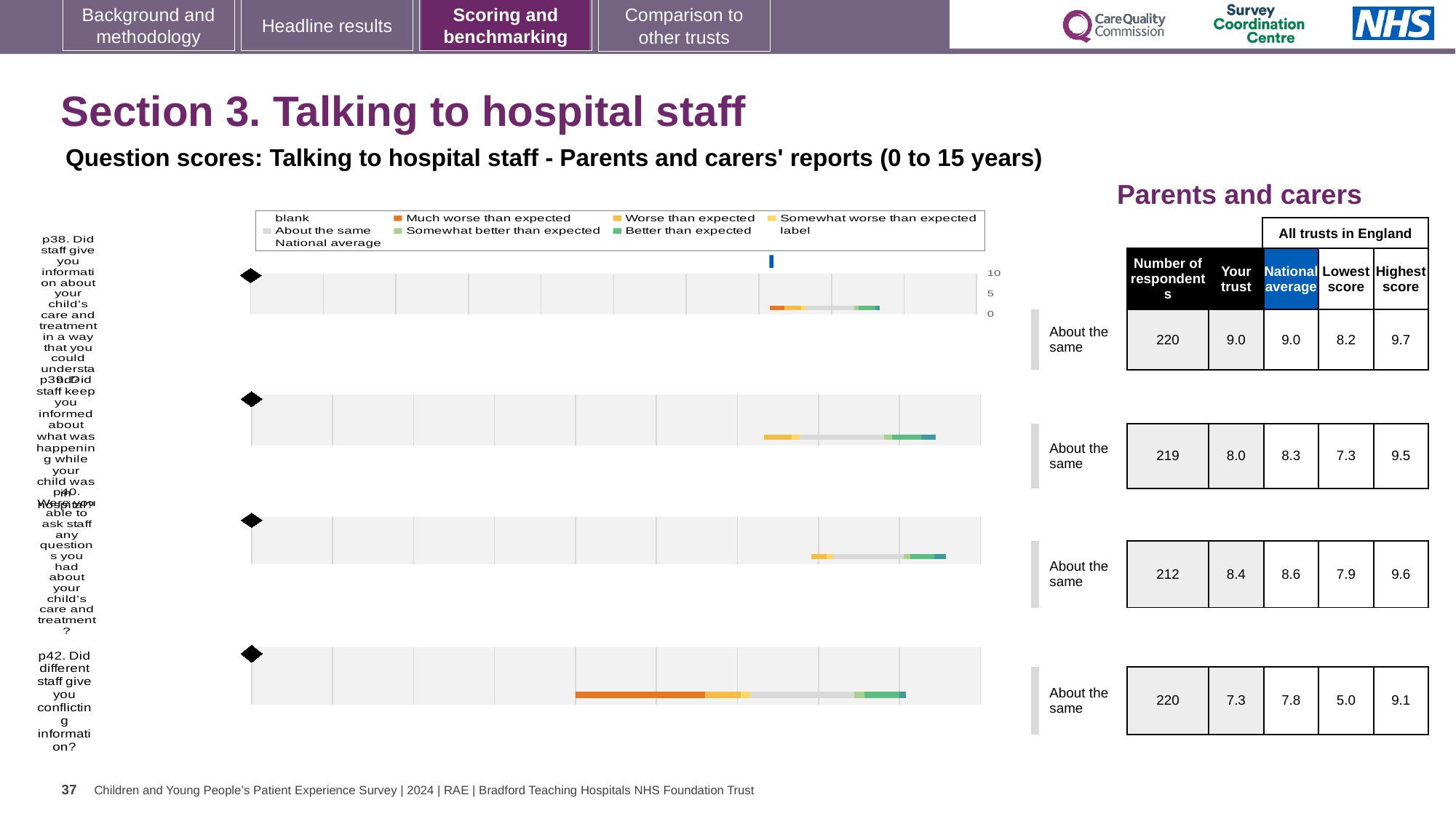
What colour represents 'Much worse than expected' in the legend? orange What kind of chart is used for each question on this slide? bar chart For p39 (Did staff keep you informed about what was happening while your child was in hospital?), what is the difference between the National average and the 'Your trust' score? 0.3 What is the Highest score across all trusts in England for p42? 9.1 For p40 (Were you able to ask staff any questions you had about your child's care and treatment?), which is larger: the 'Your trust' score or the National average? National average How many question charts are shown on the slide? 4 Which question has the highest 'Your trust' score? p38 For p42 (Did different staff give you conflicting information?), what is the National average score? 7.8 For p38 (Did staff give you information about your child's care and treatment in a way that you could understand?), what is the 'Your trust' score? 9.0 What benchmark category label is shown next to each of the four question charts? About the same How many respondents are recorded for p40? 212 Which question has the lowest 'Your trust' score? p42